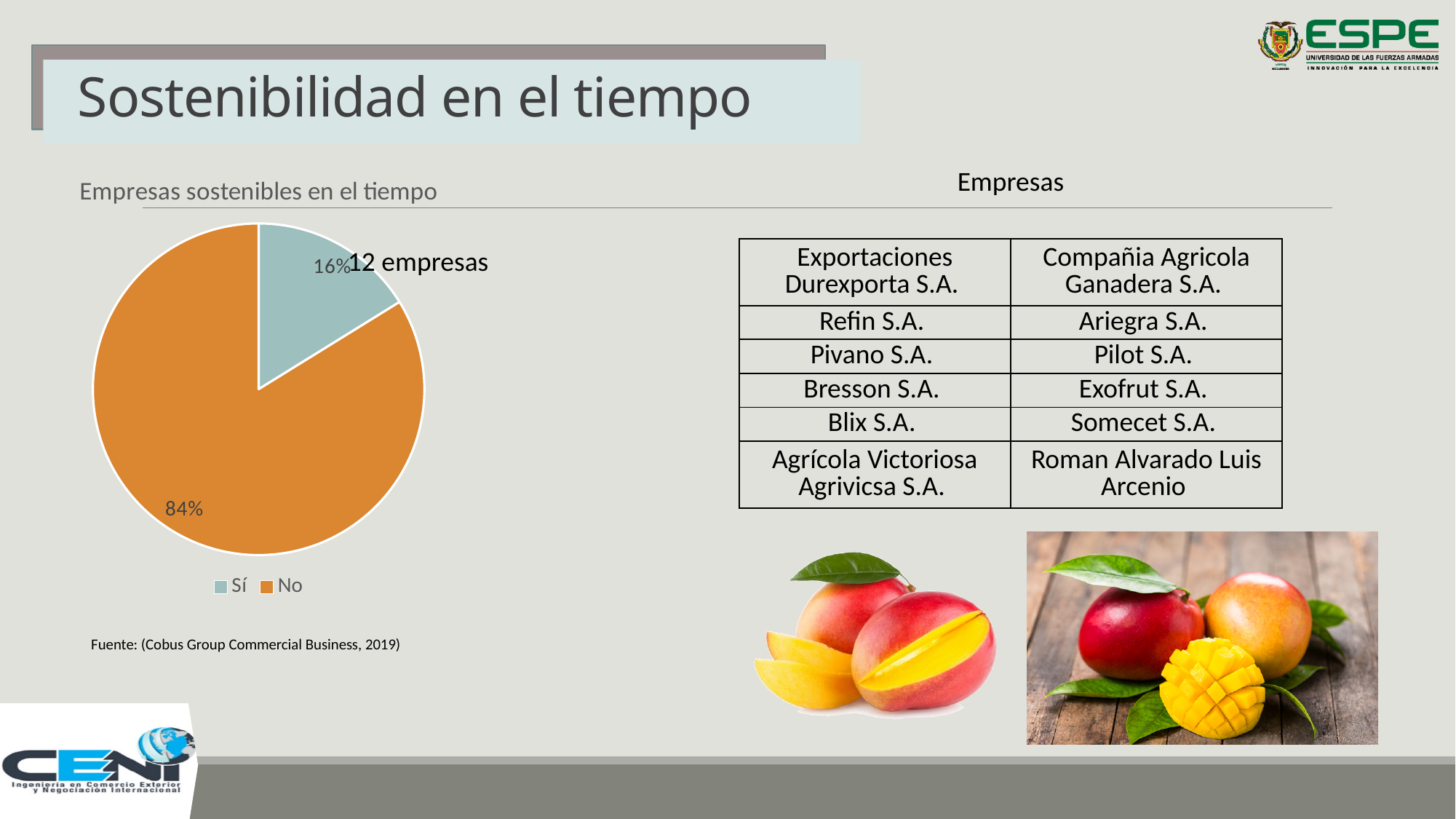
How many slices does the pie chart have? 2 What percentage of the pie is labelled "Sí"? 16% How many companies does the annotation next to the "Sí" slice say it represents? 12 Which slice of the pie is the smallest? Sí Which slice of the pie is the largest? No What colour is the "No" slice in the pie chart? orange How many entries does the legend list? 2 What kind of chart is shown on the slide? pie chart What is the difference in percentage points between the "No" slice and the "Sí" slice? 68 What is the title of the chart? Empresas sostenibles en el tiempo What percentage of the pie is labelled "No"? 84% Which slice is larger, "Sí" or "No"? No